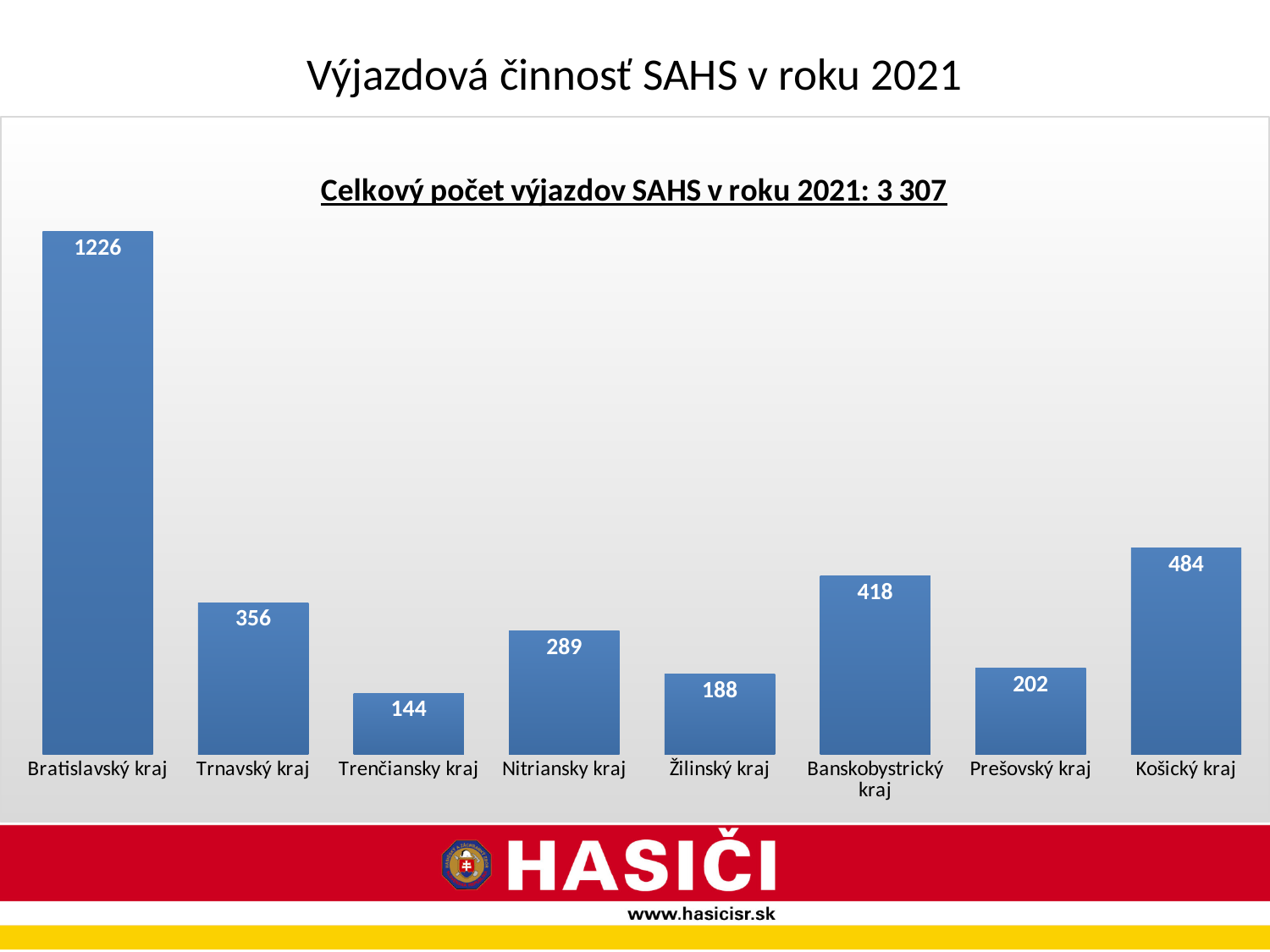
Which is larger, the value for Prešovský kraj or the value for Žilinský kraj? Prešovský kraj What kind of chart is shown on the slide? bar chart What is the difference between the values for Košický kraj and Banskobystrický kraj? 66 What is the value for Košický kraj? 484 Which region has the highest value? Bratislavský kraj What is the difference between the values for Trnavský kraj and Nitriansky kraj? 67 How many regions are shown on the chart? 8 What is the chart's title? Celkový počet výjazdov SAHS v roku 2021: 3 307 What is the value for Bratislavský kraj? 1226 Which region has the lowest value? Trenčiansky kraj What is the value for Banskobystrický kraj? 418 What is the value for Trenčiansky kraj? 144